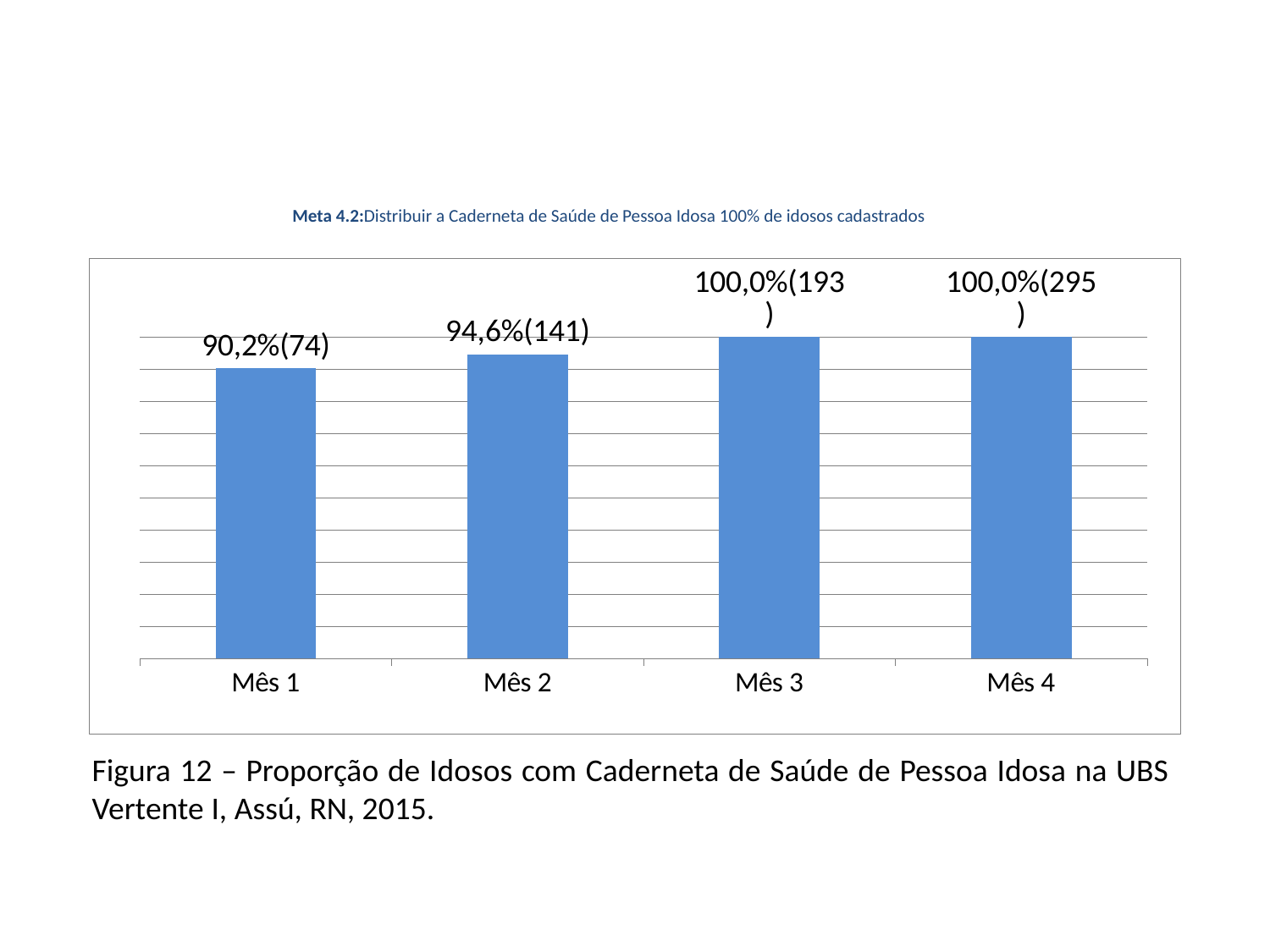
What is the difference in percentage points between Mês 2 and Mês 1? 4,4 How many months (bars) are shown in the chart? 4 What number appears in parentheses in the data label for Mês 3? 193 What number appears in parentheses in the data label for Mês 4? 295 What percentage is shown for Mês 2? 94,6% What is the figure number given in the caption below the chart? Figura 12 What percentage is shown for Mês 1? 90,2% Which month has the lowest percentage? Mês 1 What kind of chart is shown on the slide? Bar chart Do the percentages rise or fall from Mês 1 to Mês 4? Rise Which is larger, the percentage for Mês 1 or for Mês 2? Mês 2 What is the difference between the counts in parentheses for Mês 4 and Mês 3? 102